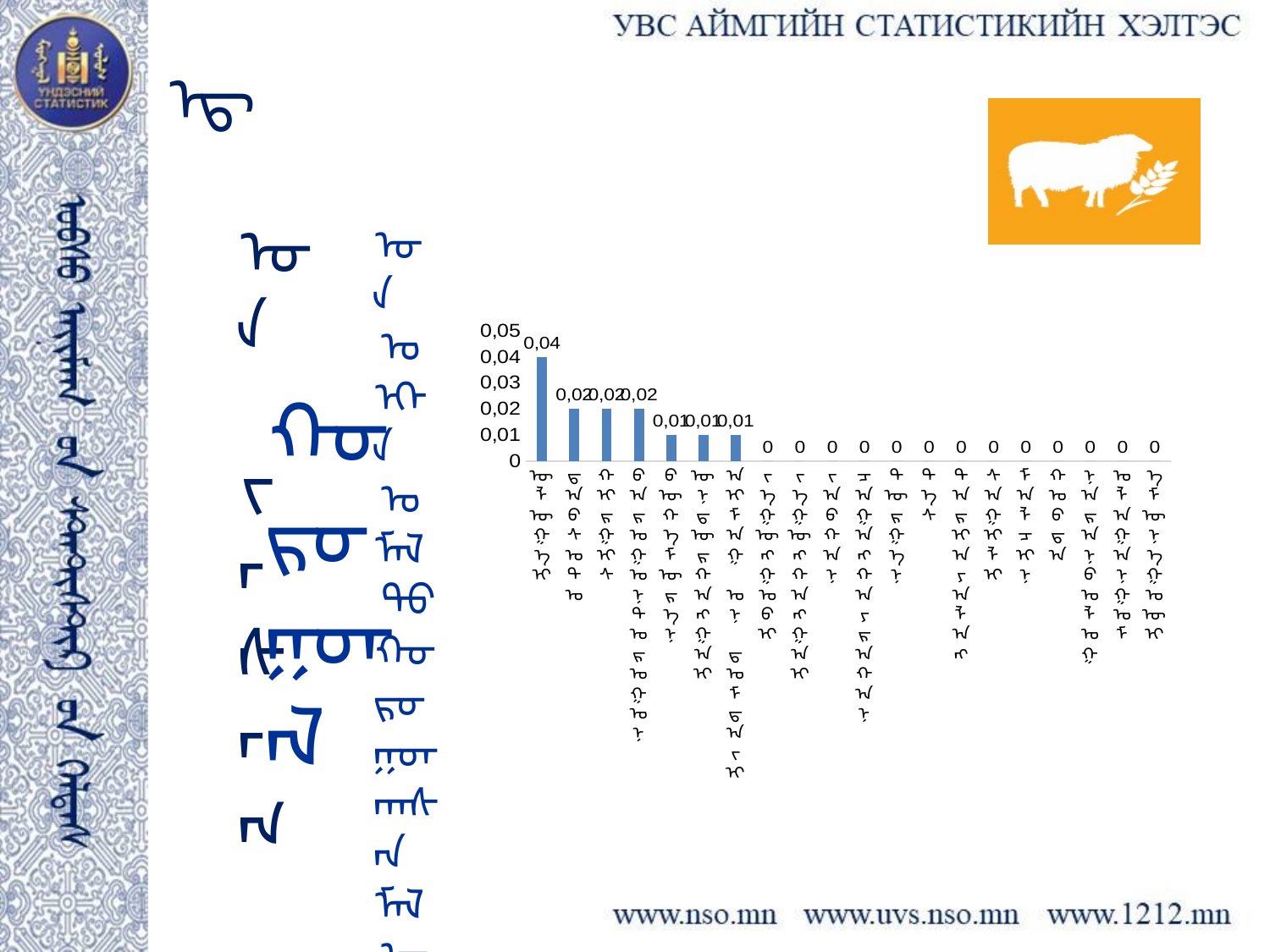
What is the highest tick value shown on the vertical axis? 0,05 What is the difference between the first bar (0,04) and the second bar (0,02)? 0,02 Do the bar values rise or fall moving from left to right along the x axis? fall What is the value of the fifth bar from the left? 0,01 What is the value of the second bar from the left? 0,02 What is the value of the leftmost (first) bar in the chart? 0,04 What is the lowest value shown in the chart? 0 How many bars in the chart have a data label of 0,02? 3 What is the highest value shown in the chart? 0,04 How many bars (categories) are plotted in the chart? 20 What kind of chart is shown on the slide? bar chart How many bars in the chart have a data label of 0? 13